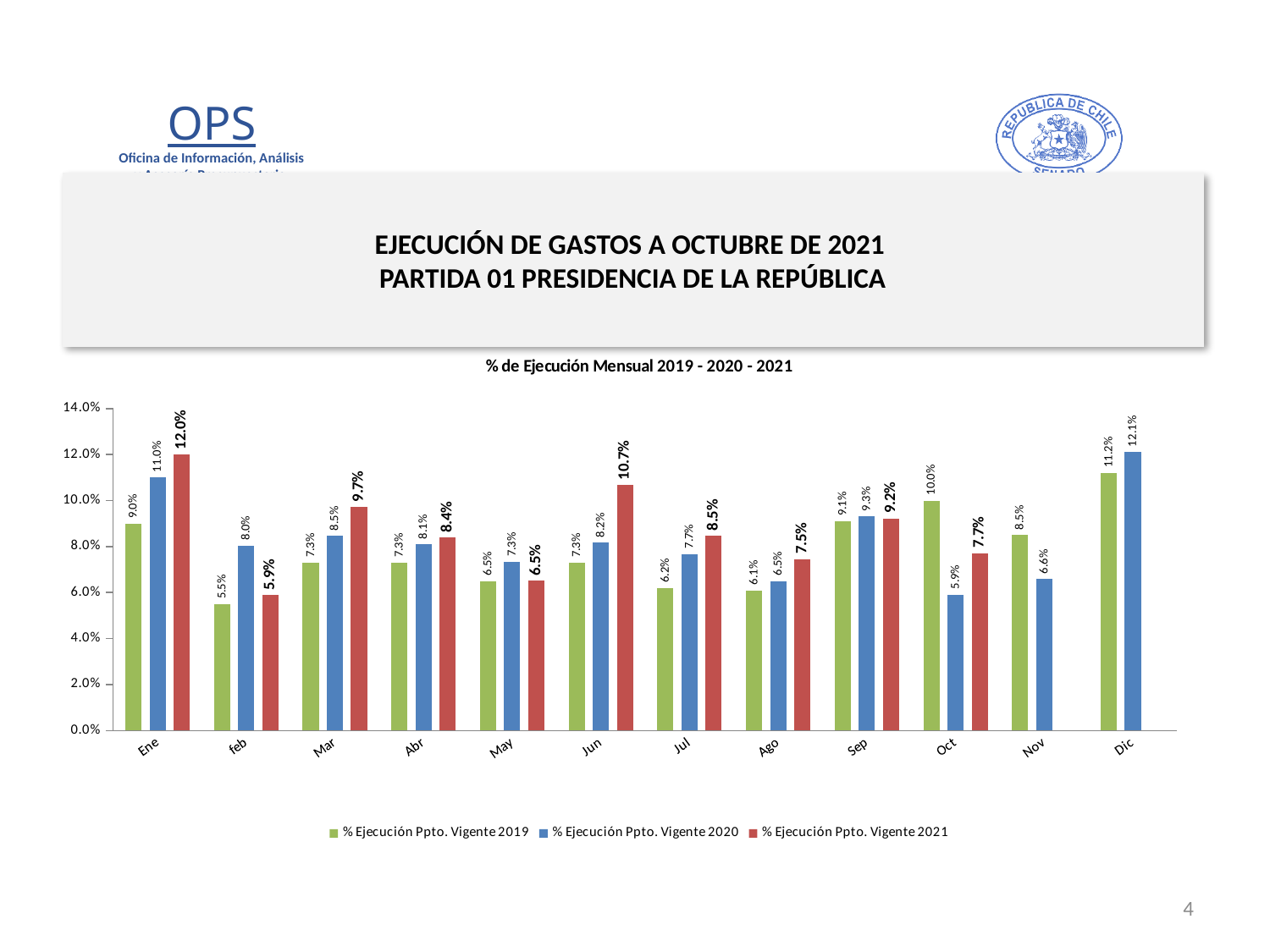
What is the title of the chart? % de Ejecución Mensual 2019 - 2020 - 2021 What kind of chart is shown on the slide? Bar chart What is the % Ejecución Ppto. Vigente 2020 value for Dic? 12.1% What is the difference between the 2021 and 2019 values for Ene? 3.0% Which month has the highest % Ejecución Ppto. Vigente 2021 value? Ene For Oct, which is larger: the 2019 value or the 2020 value? 2019 value Is the % Ejecución Ppto. Vigente 2020 value for Ene greater or less than 10.0%? greater Which month has the lowest % Ejecución Ppto. Vigente 2019 value? feb How many months are shown on the x axis? 12 What is the % Ejecución Ppto. Vigente 2019 value for Oct? 10.0% What is the % Ejecución Ppto. Vigente 2021 value for Jun? 10.7% How many series does the legend list? 3